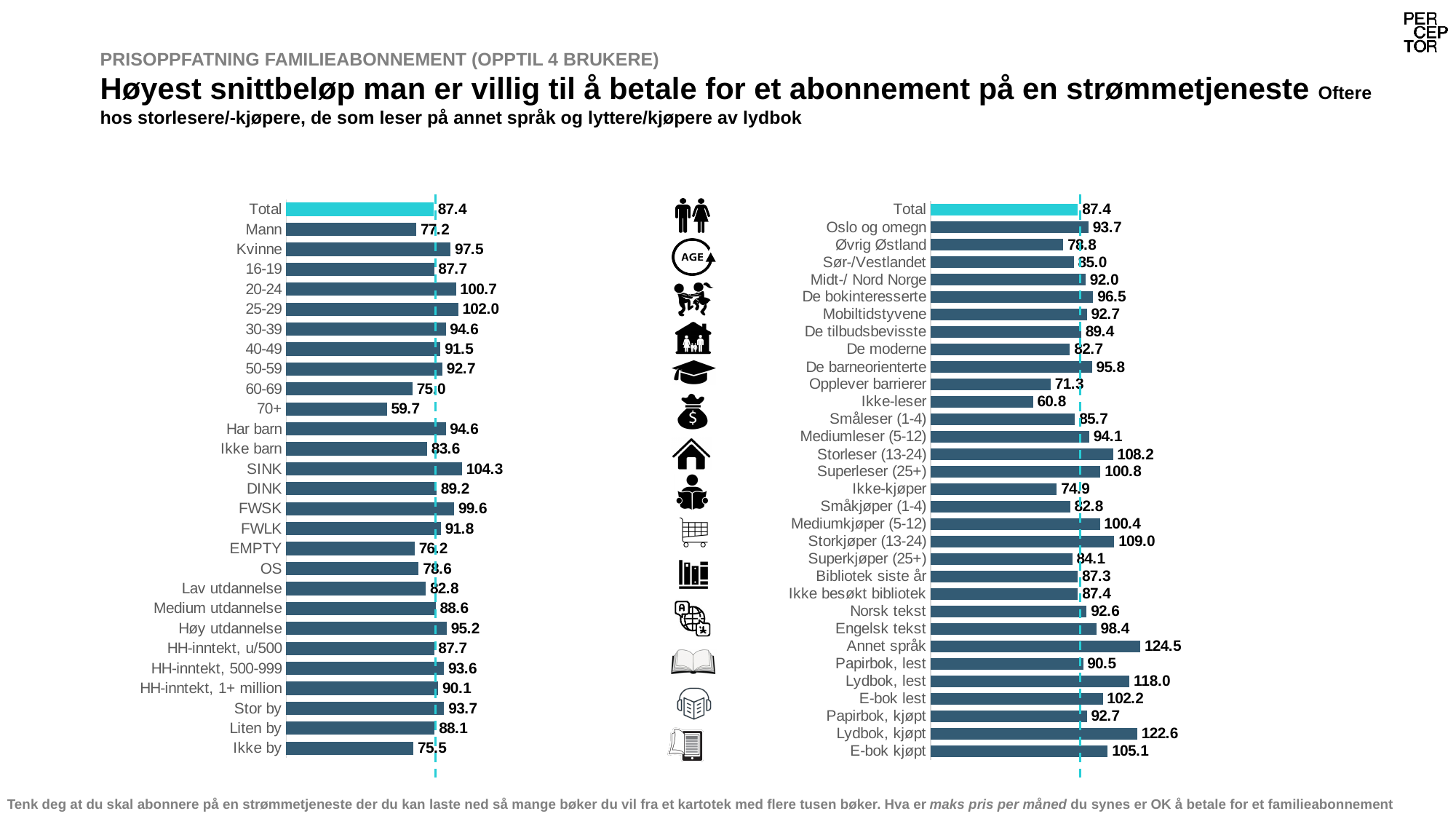
How many categories are shown in the right chart? 32 In the left chart, what is the value for SINK? 104.3 In the left chart, what is the value for Kvinne? 97.5 In the right chart, which category has the lowest value? Ikke-leser How many categories are shown in the left chart? 28 In the left chart, what is the difference between the values for Kvinne and Mann? 20.3 In the right chart, what is the value for Lydbok, kjøpt? 122.6 In the right chart, which category has the highest value? Annet språk What type of chart is the left chart? Bar chart In the left chart, which category has the lowest value? 70+ In the left chart, which is larger, the value for Stor by or Ikke by? Stor by In the right chart, which is larger, the value for Storkjøper (13-24) or Storleser (13-24)? Storkjøper (13-24)